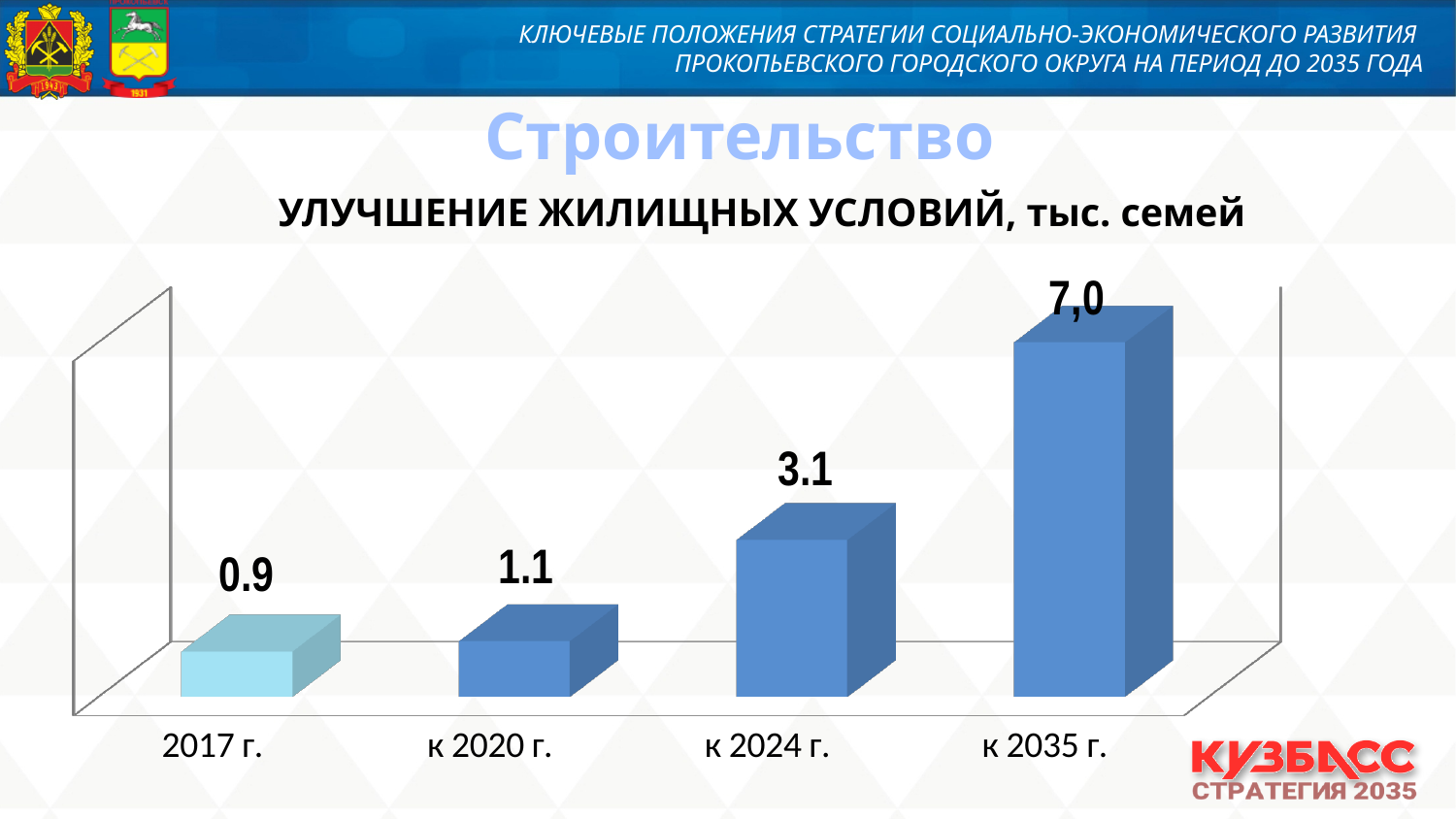
Which is larger, the value for к 2024 г. or the value for к 2020 г.? к 2024 г. What is the value for 2017 г.? 0.9 What is the value for к 2035 г.? 7,0 Do the values rise or fall from 2017 г. to к 2035 г.? Rise Which category has the lowest value? 2017 г. How many categories are shown on the chart? 4 What is the value for к 2024 г.? 3.1 What is the difference between the values for к 2035 г. and к 2024 г.? 3.9 What kind of chart is shown on the slide? Bar chart Which category has the highest value? к 2035 г. What is the difference between the values for к 2024 г. and к 2020 г.? 2.0 What is the value for к 2020 г.? 1.1